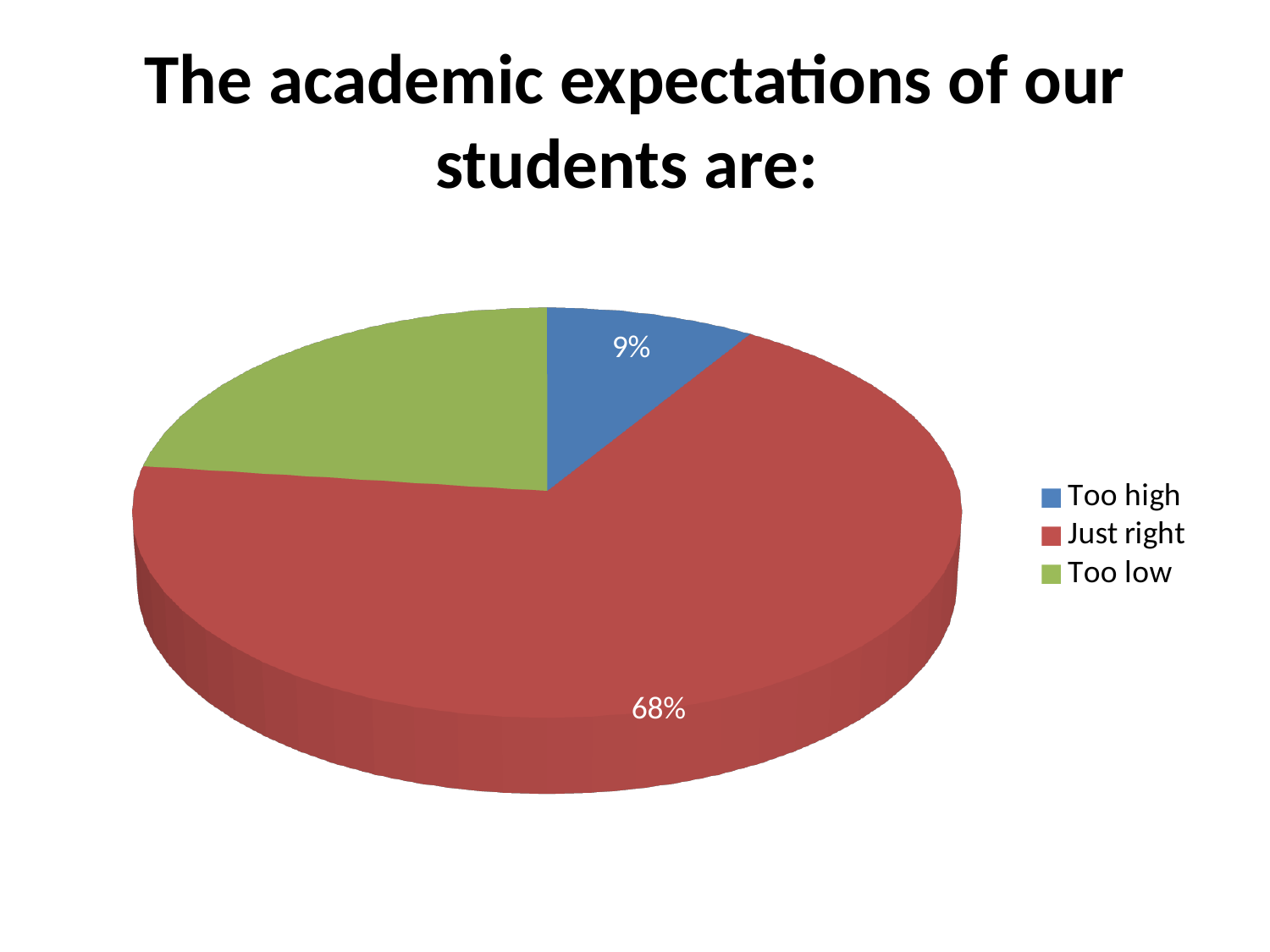
By how many percentage points does 'Just right' exceed 'Too high'? 59 percentage points How many entries does the legend list? 3 What percentage of the pie is labelled for the 'Just right' slice? 68% What is the title of the slide? The academic expectations of our students are: What type of chart is shown on the slide? Pie chart Which slice is larger, 'Too low' or 'Too high'? Too low Which category has the largest share of the pie? Just right Which category has the smallest share of the pie? Too high What colour represents the 'Just right' category? Red How many categories are shown in the pie chart? 3 Which slice is larger, 'Just right' or 'Too low'? Just right What percentage is shown for the 'Too high' slice? 9%